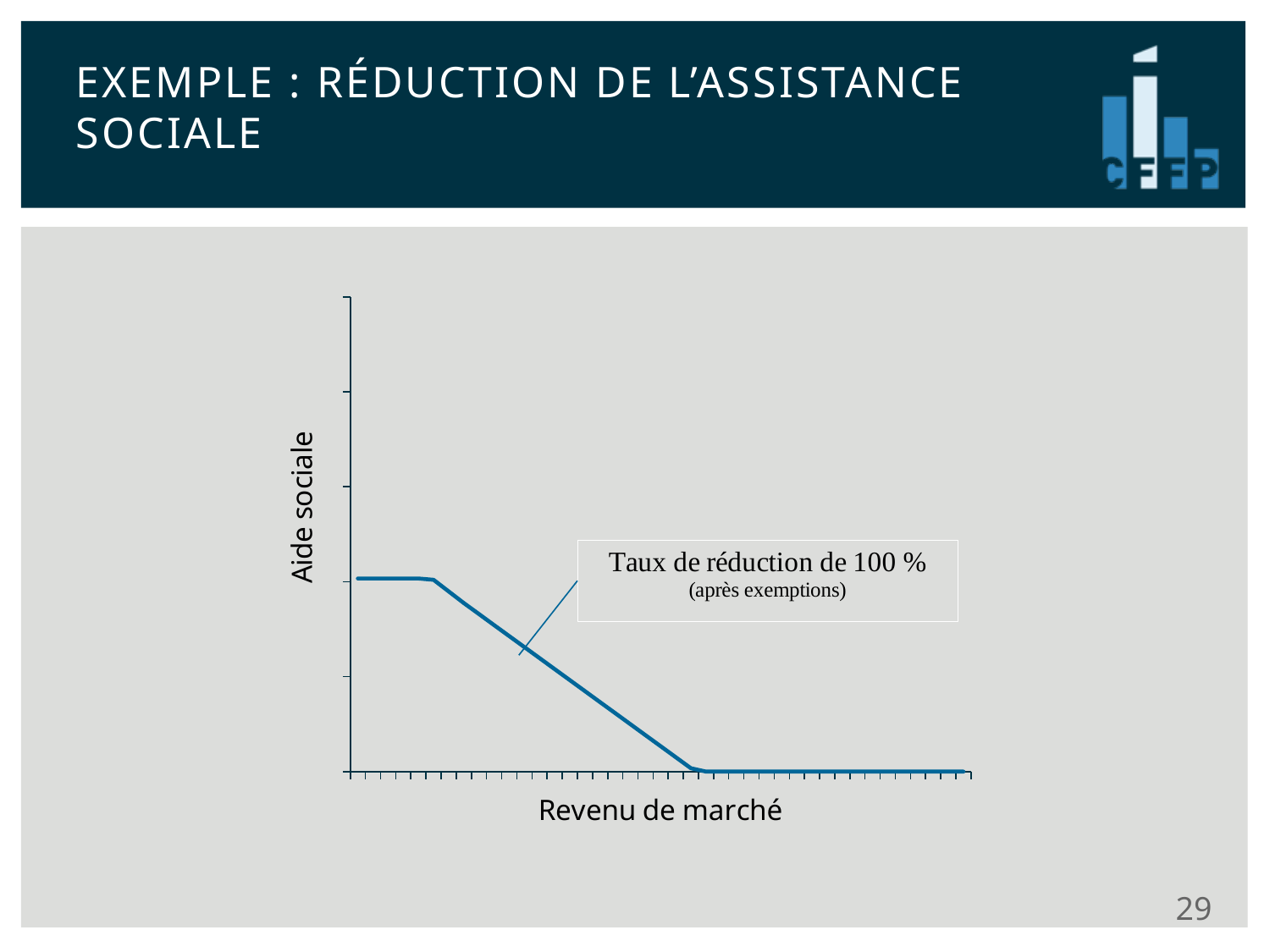
What is the label of the x axis of the chart? Revenu de marché What is the label of the y axis of the chart? Aide sociale What kind of chart is shown on the slide? line chart Overall, does the plotted line rise or fall as you move along the x axis? fall How many lines are plotted on the chart? 1